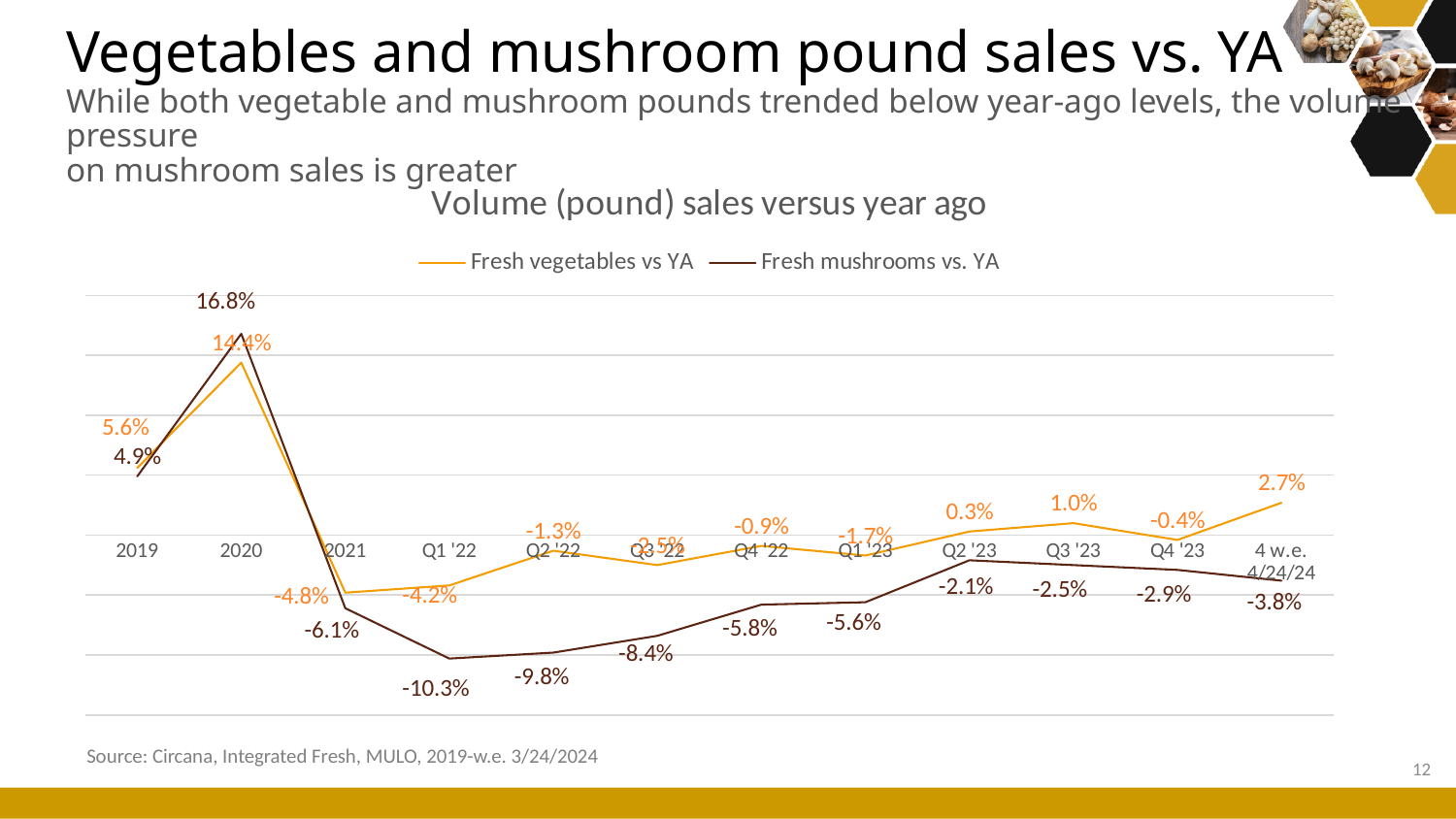
In 2020, how much higher is the Fresh mushrooms vs. YA value than the Fresh vegetables vs YA value? 2.4 percentage points What is the value for Fresh vegetables vs YA in Q4 '23? -0.4% What kind of chart is shown on the slide? Line chart What is the title of the chart? Volume (pound) sales versus year ago How many series does the legend list? 2 In Q1 '22, which series has the lower value, Fresh vegetables vs YA or Fresh mushrooms vs. YA? Fresh mushrooms vs. YA In which period is the Fresh mushrooms vs. YA value lowest? Q1 '22 What is the value for Fresh vegetables vs YA for the 4 w.e. 4/24/24 period? 2.7% How many time periods are plotted along the x axis? 12 In which period is the Fresh vegetables vs YA value highest? 2020 What is the value for Fresh mushrooms vs. YA in 2020? 16.8% What is the value for Fresh mushrooms vs. YA in Q2 '23? -2.1%